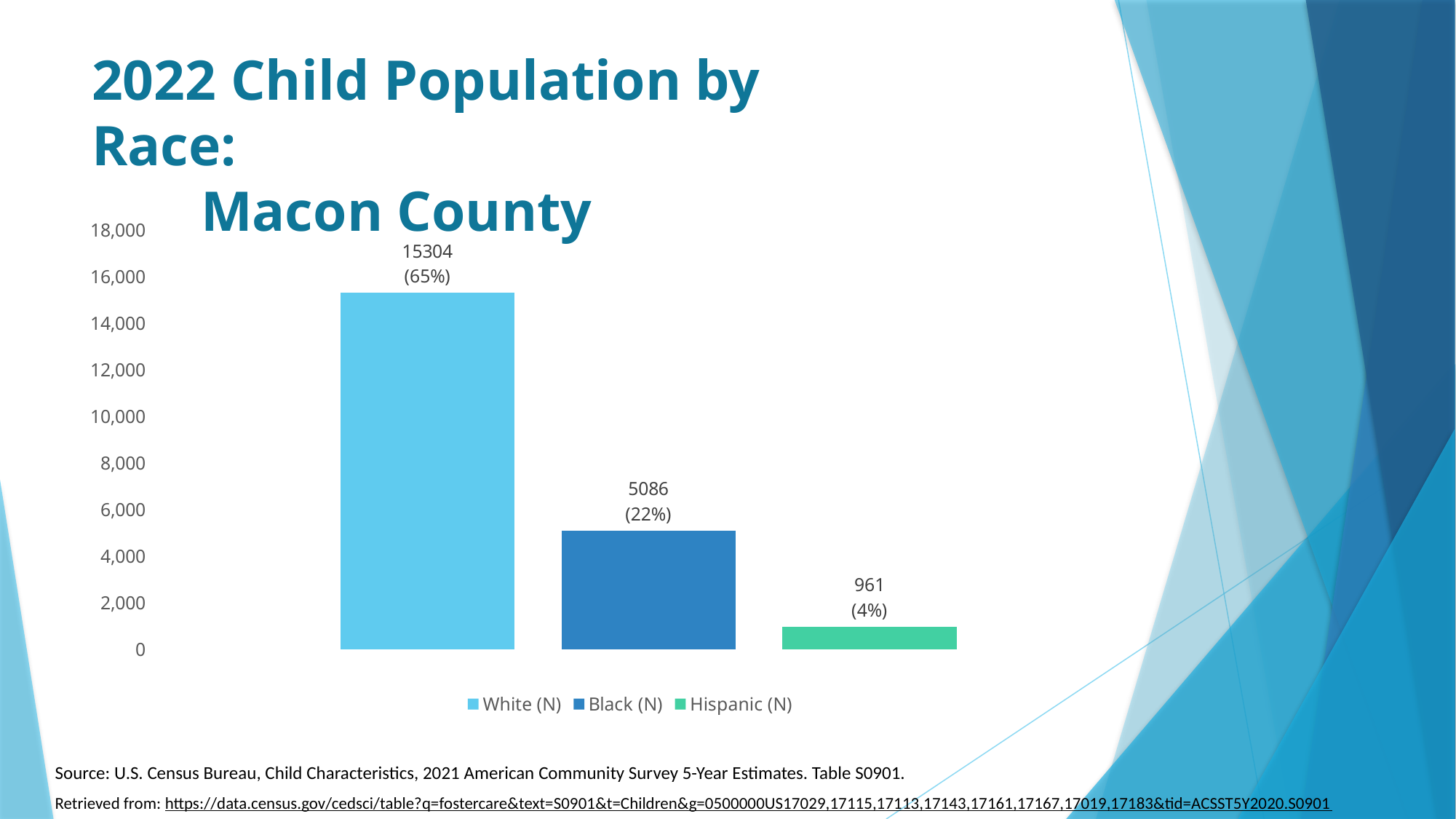
Which category has the lowest value? Hispanic (N) What is the value for Black (N)? 5086 What is the difference between the White (N) and Black (N) values? 10218 What percentage is shown for Black (N)? 22% How many series does the legend list? 3 What is the value for Hispanic (N)? 961 Is the value for Black (N) greater or less than 6,000? less What is the value for White (N)? 15304 Which is larger, the value for Black (N) or Hispanic (N)? Black (N) What kind of chart is shown on the slide? bar chart Which category has the highest value? White (N) What colour is the bar for Hispanic (N)? green